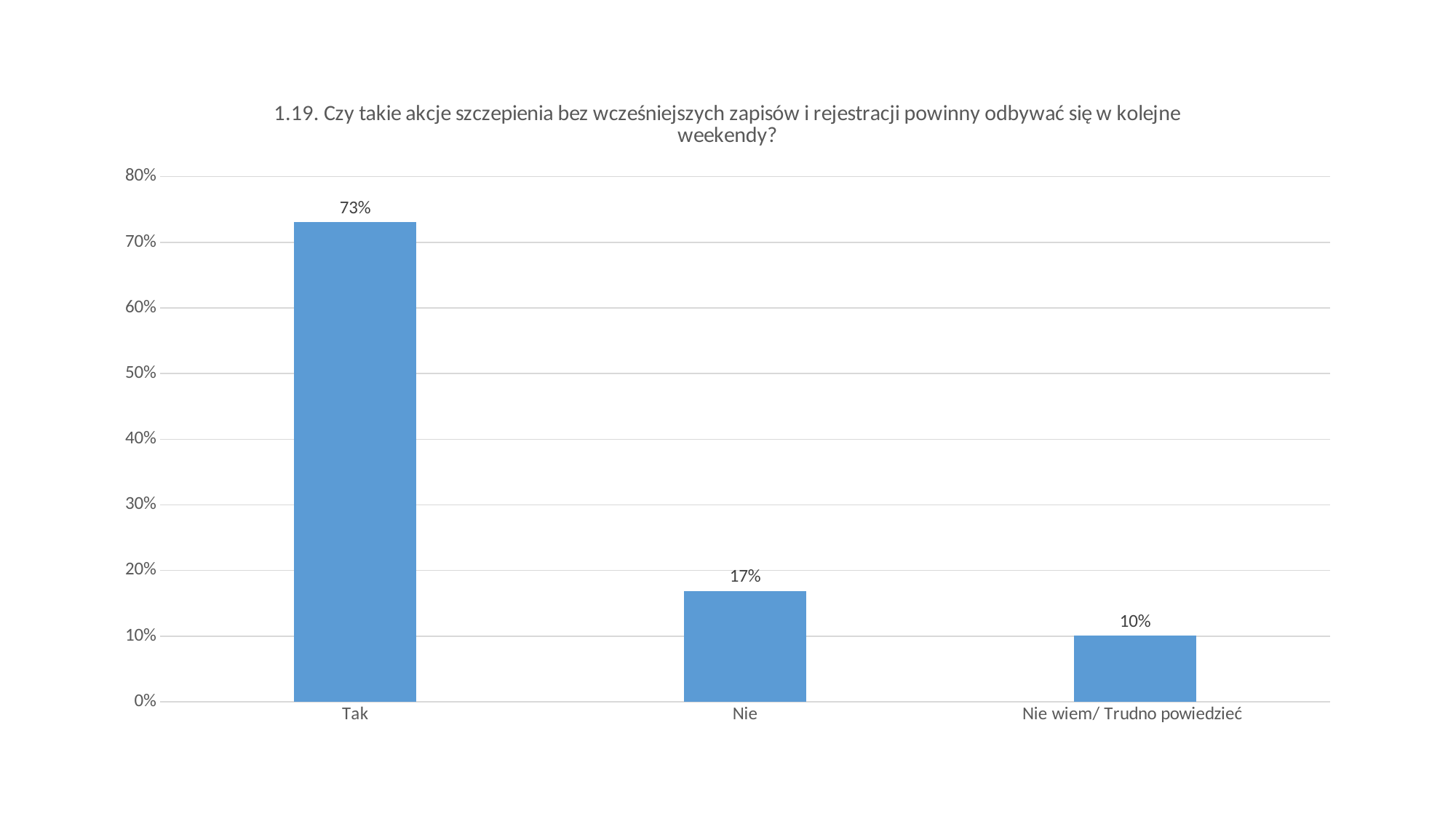
Which is larger, the value for Nie or the value for Nie wiem/ Trudno powiedzieć? Nie Which category has the highest value? Tak How many categories are shown on the x axis? 3 What is the difference between the values for Nie and Nie wiem/ Trudno powiedzieć? 7% What is the value for Nie? 17% What kind of chart is shown on the slide? bar chart What is the highest value shown on the y axis? 80% Is the value for Tak greater or less than 70%? greater What is the value for Tak? 73% What is the value for Nie wiem/ Trudno powiedzieć? 10% Which category has the lowest value? Nie wiem/ Trudno powiedzieć What is the difference between the values for Tak and Nie? 56%